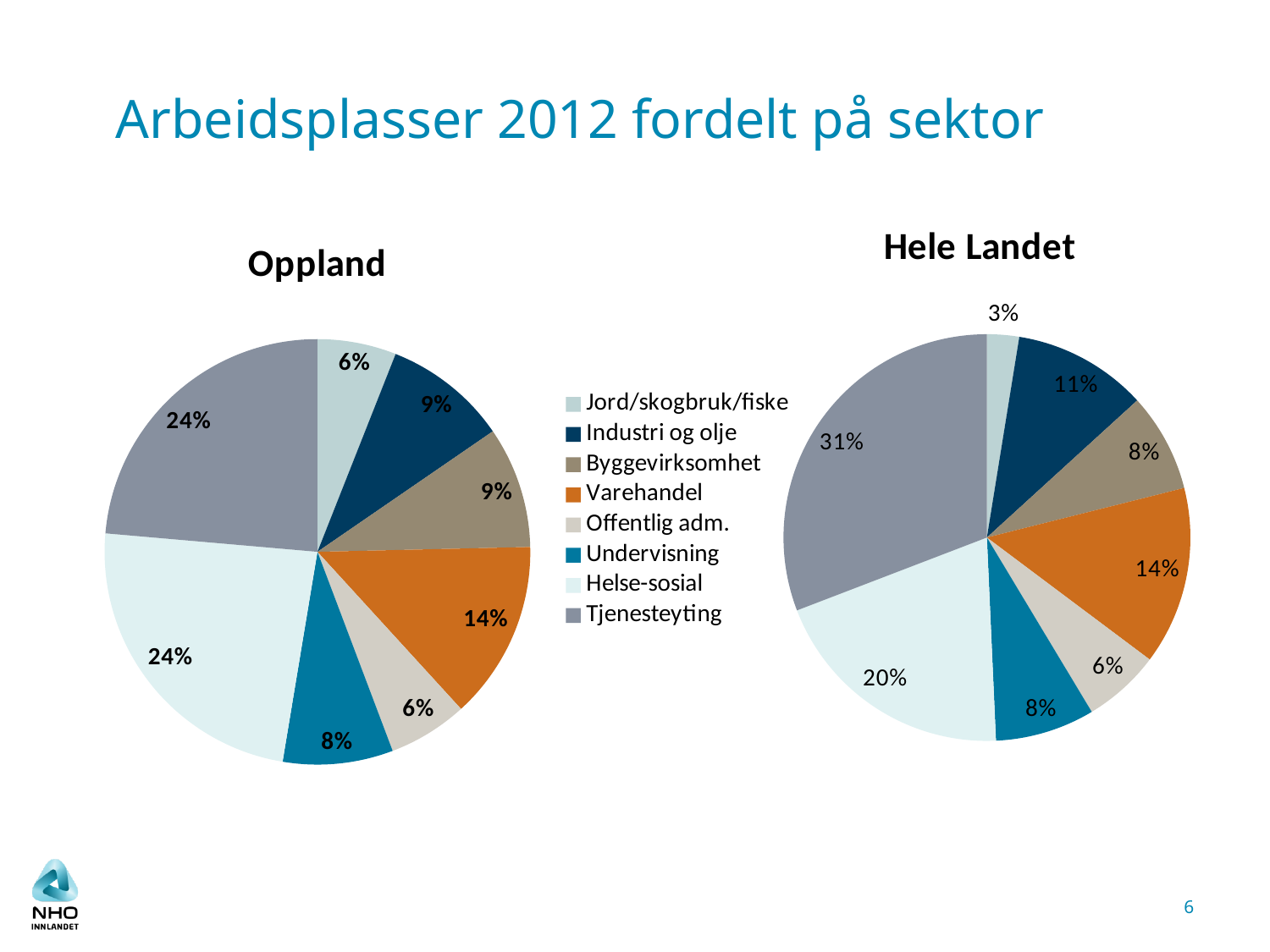
In the Hele Landet pie chart, which is larger: Helse-sosial or Tjenesteyting? Tjenesteyting In the Hele Landet pie chart, which sector has the largest share? Tjenesteyting How many sectors does the legend list? 8 In the Hele Landet pie chart, what share is Jord/skogbruk/fiske? 3% What is the difference between the Tjenesteyting share in the Hele Landet chart and the Tjenesteyting share in the Oppland chart? 7% In the Hele Landet pie chart, which sector has the smallest share? Jord/skogbruk/fiske In the Oppland pie chart, what share is Undervisning? 8% In the Oppland pie chart, what share is Varehandel? 14% In the Hele Landet pie chart, what share is Tjenesteyting? 31% What type of chart is used for Oppland and Hele Landet? Pie chart In the Oppland pie chart, which is larger: Industri og olje or Varehandel? Varehandel What is the title of the slide? Arbeidsplasser 2012 fordelt på sektor